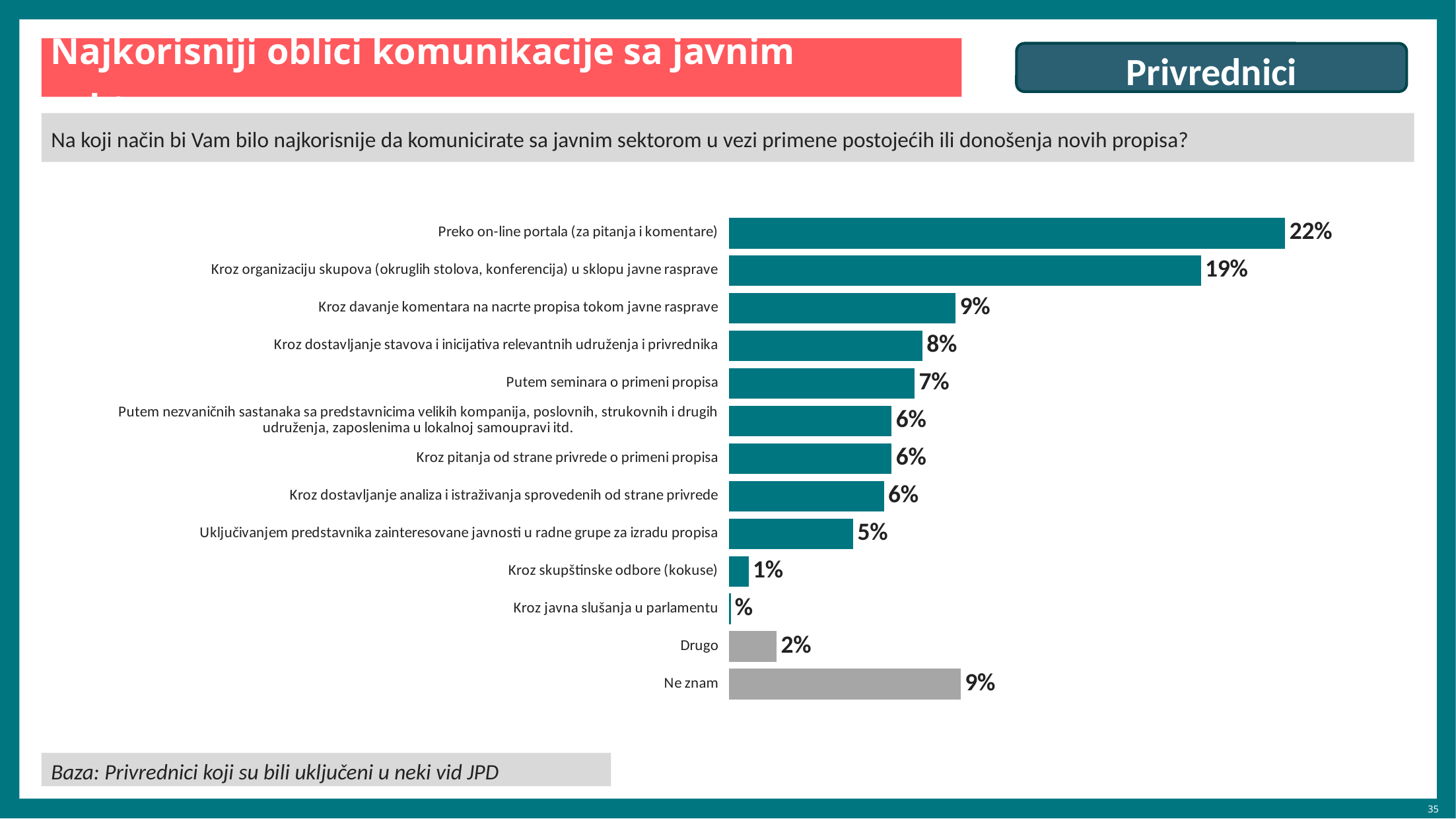
What colour are the bars for "Drugo" and "Ne znam"? grey What is the value for "Preko on-line portala (za pitanja i komentare)"? 22% Which is larger, the value for "Kroz davanje komentara na nacrte propisa tokom javne rasprave" or the value for "Uključivanjem predstavnika zainteresovane javnosti u radne grupe za izradu propisa"? Kroz davanje komentara na nacrte propisa tokom javne rasprave What is the value for "Kroz organizaciju skupova (okruglih stolova, konferencija) u sklopu javne rasprave"? 19% What is the value for "Putem seminara o primeni propisa"? 7% Which category has the highest value? Preko on-line portala (za pitanja i komentare) What kind of chart is shown on the slide? bar chart What is the difference between the values for "Preko on-line portala (za pitanja i komentare)" and "Kroz organizaciju skupova (okruglih stolova, konferencija) u sklopu javne rasprave"? 3 percentage points What is the value for "Ne znam"? 9% Which is larger, the value for "Ne znam" or the value for "Drugo"? Ne znam What is the value for "Kroz skupštinske odbore (kokuse)"? 1% How many categories are shown in the chart? 13